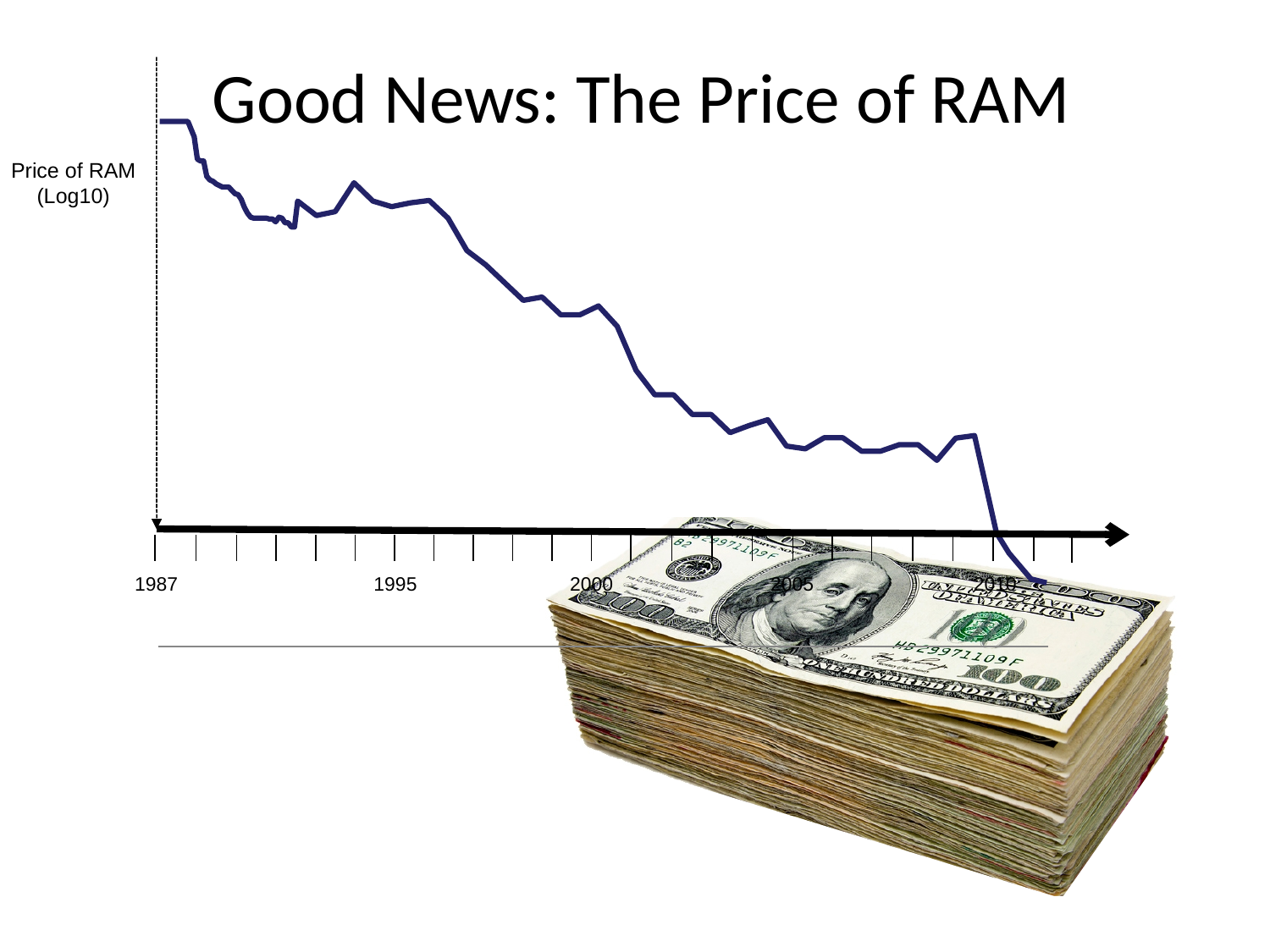
How many year labels are printed on the x axis? 5 Does the price of RAM rise or fall over time along the x axis? Fall What is the title of the chart on the slide? Good News: The Price of RAM Is the price of RAM higher in 1987 or in 2010? 1987 Is the price of RAM higher in 2000 or in 2005? 2000 Which year shown on the x axis has the lowest price of RAM? 2010 How many lines are plotted on the chart? 1 Which year shown on the x axis has the highest price of RAM? 1987 What kind of chart is shown on the slide? Line chart What is the label on the vertical axis of the chart? Price of RAM (Log10) Is the price of RAM higher in 1995 or in 2005? 1995 What is the first year labeled on the x axis? 1987